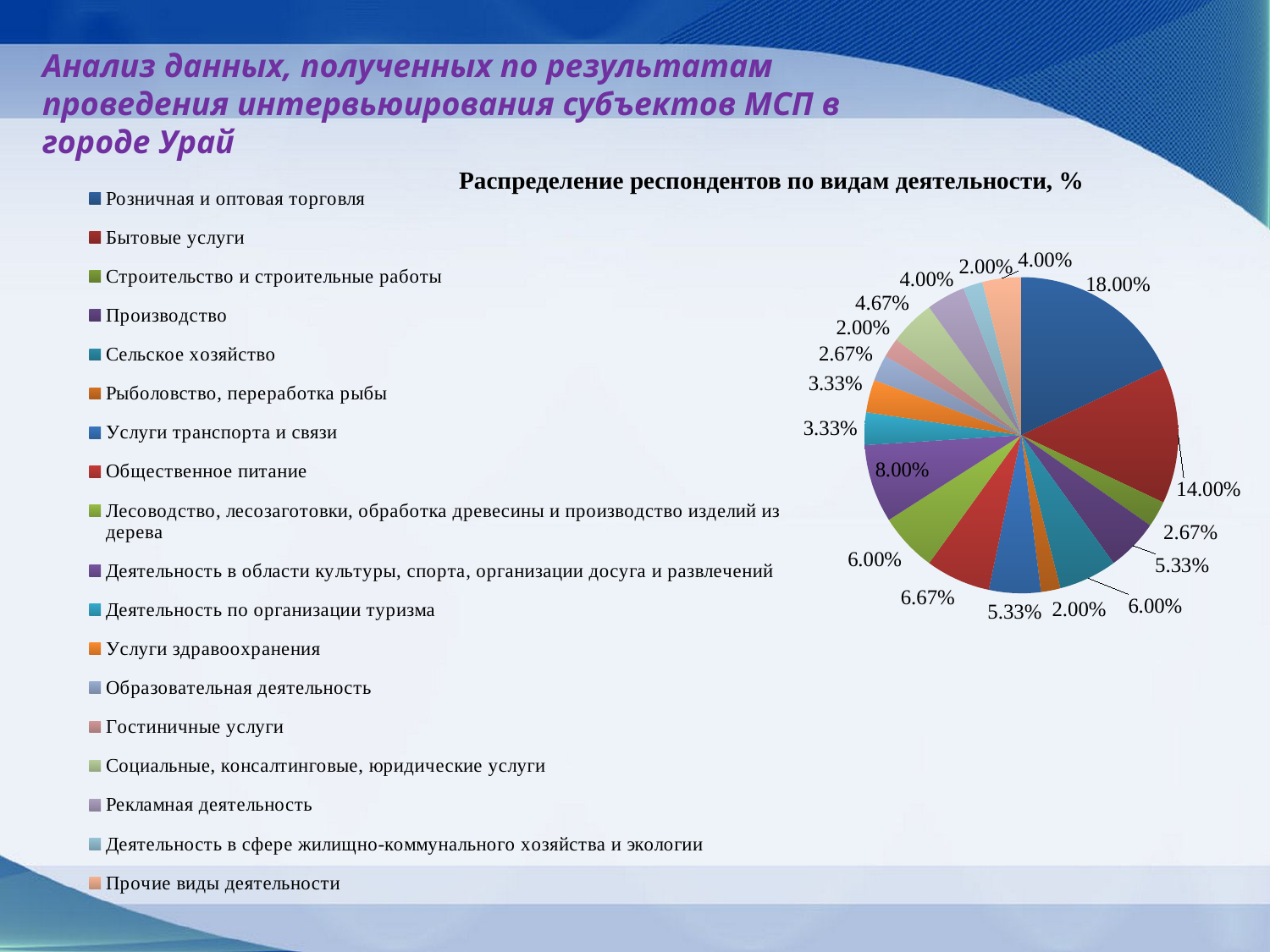
What is the difference between the shares of Розничная и оптовая торговля and Бытовые услуги? 4.00% What share of respondents is in Деятельность в области культуры, спорта, организации досуга и развлечений? 8.00% Which type of activity has the largest share of respondents? Розничная и оптовая торговля What share of respondents is in Социальные, консалтинговые, юридические услуги? 4.67% What kind of chart is shown on the slide? pie chart What share of respondents is in Розничная и оптовая торговля? 18.00% What share of respondents is in Бытовые услуги? 14.00% What is the smallest share value shown on the pie chart? 2.00% How many categories does the legend of the pie chart list? 18 What is the title of the chart? Распределение респондентов по видам деятельности, % Which has a larger share: Бытовые услуги or Деятельность в области культуры, спорта, организации досуга и развлечений? Бытовые услуги What share of respondents is in Общественное питание? 6.67%